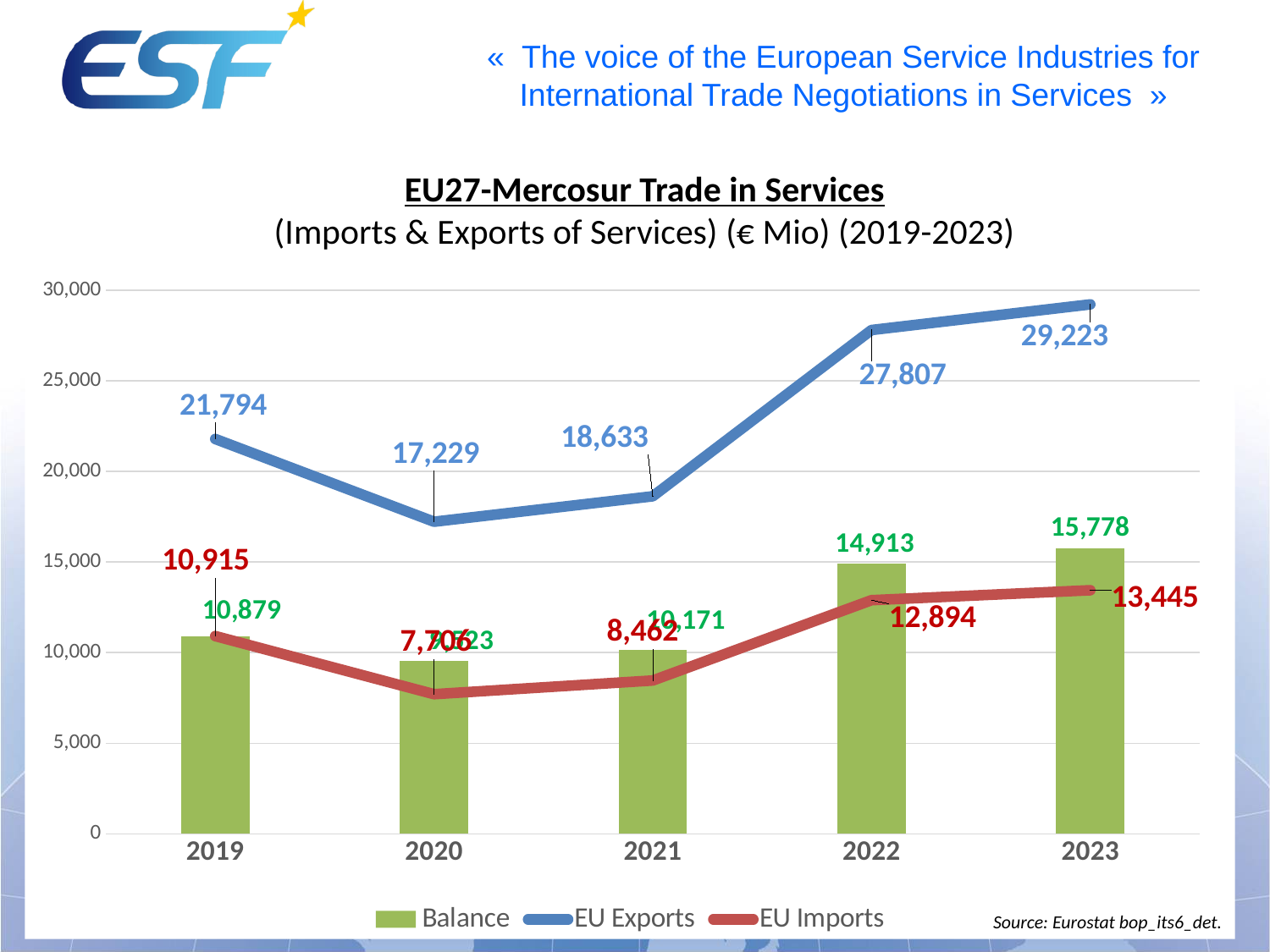
What kind of chart is this? Combined bar and line chart In which year are EU Exports highest? 2023 In which year are EU Exports lowest? 2020 What is the value of EU Exports in 2023? 29,223 What is the source cited for the chart data? Eurostat bop_its6_det. What is the value of EU Imports in 2019? 10,915 How many series does the legend list? 3 How many years are shown on the x axis? 5 Which is larger in 2023, the Balance or EU Imports? Balance By how much did EU Exports increase from 2022 to 2023? 1,416 What is the Balance value shown for 2022? 14,913 Is the Balance value for 2020 greater or less than 5,000? greater